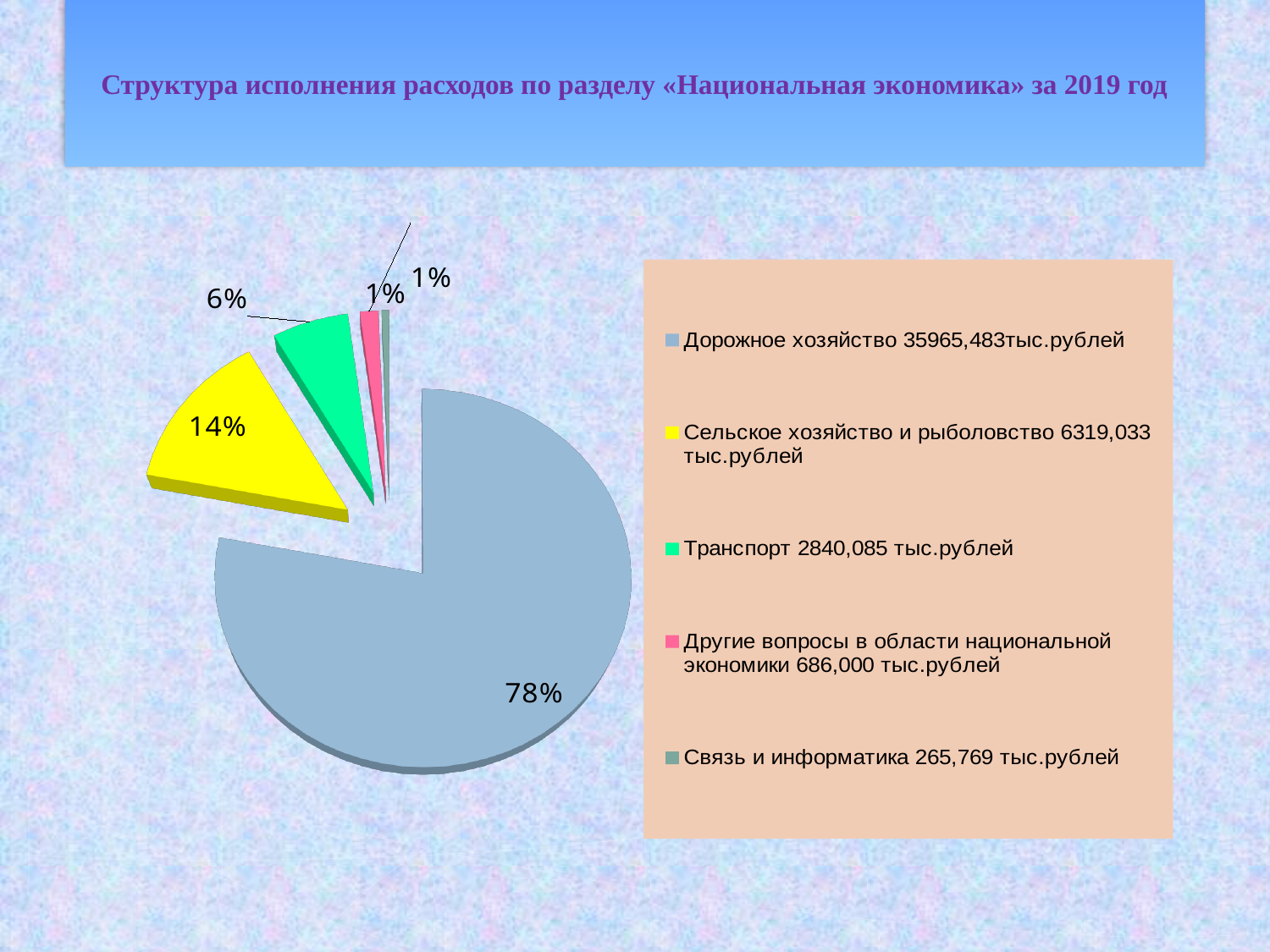
What amount does the legend give for Дорожное хозяйство? 35965,483тыс.рублей Which category has the largest slice of the pie? Дорожное хозяйство What is the difference in percentage points between the Дорожное хозяйство slice and the Сельское хозяйство и рыболовство slice? 64% What amount does the legend give for Транспорт? 2840,085 тыс.рублей What kind of chart is shown on the slide? pie chart What share of the pie does Транспорт take? 6% What share of the pie does Сельское хозяйство и рыболовство take? 14% What is the title of the chart on the slide? Структура исполнения расходов по разделу «Национальная экономика» за 2019 год Which slice is larger: Транспорт or Сельское хозяйство и рыболовство? Сельское хозяйство и рыболовство What share of the pie does Дорожное хозяйство take? 78% How many slices does the pie chart have? 5 According to the legend, which category has the smallest amount in тыс.рублей? Связь и информатика